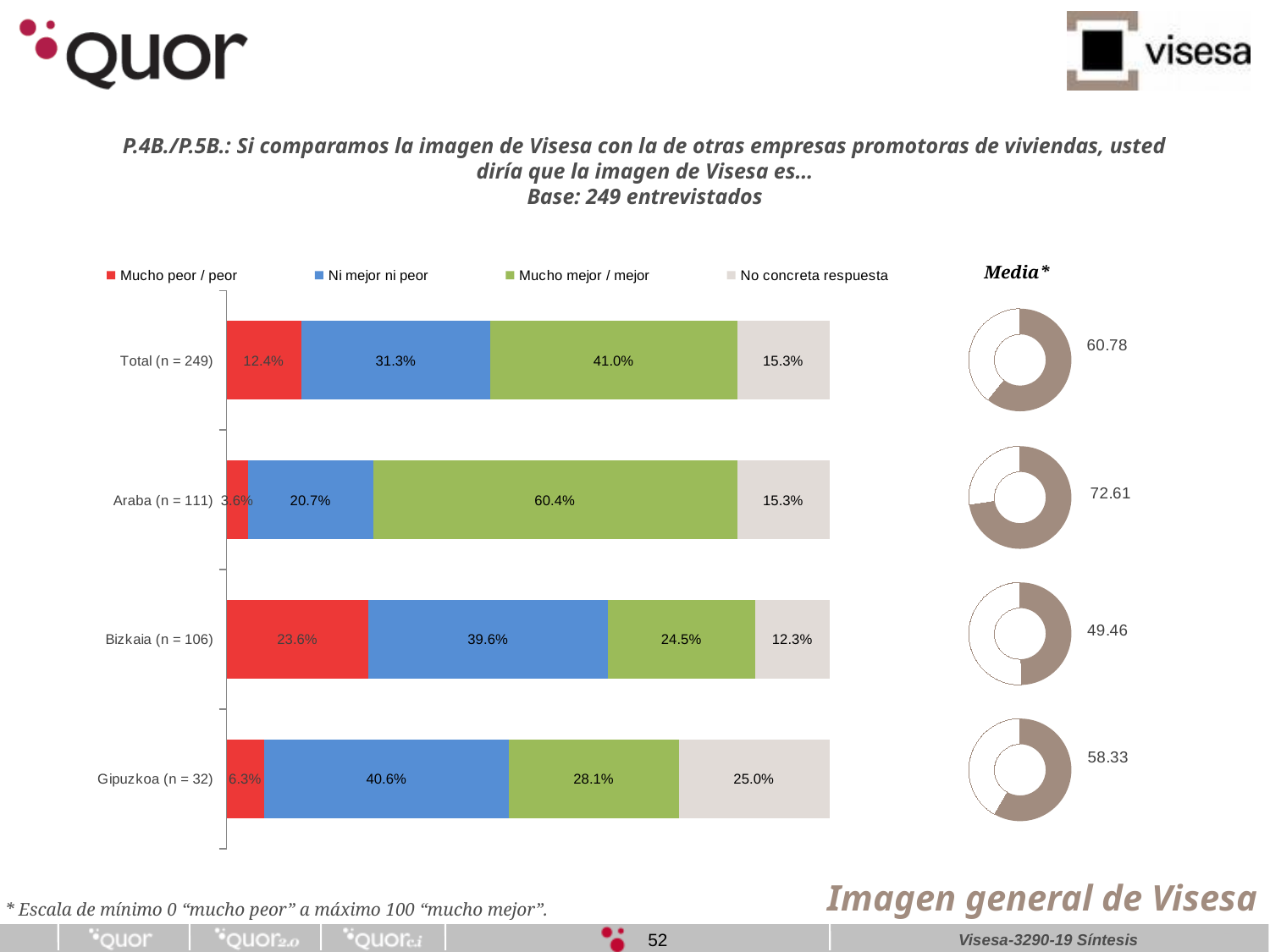
In the stacked bar chart, which category has the lowest "Mucho peor / peor" percentage? Araba (n = 111) In the stacked bar chart, what is the "No concreta respuesta" value for Gipuzkoa (n = 32)? 25.0% How many categories are shown in the stacked bar chart? 4 How many series does the legend of the stacked bar chart list? 4 In the stacked bar chart, what is the difference between the "Ni mejor ni peor" values for Gipuzkoa (n = 32) and Araba (n = 111)? 19.9% In the Media* donut charts, what is the mean value for Araba? 72.61 In the stacked bar chart, what percentage of Total (n = 249) respondents answered "Mucho mejor / mejor"? 41.0% Among the Media* donut charts, which territory has the lowest mean value? Bizkaia In the stacked bar chart, which category has the highest "Mucho mejor / mejor" percentage? Araba (n = 111) In the stacked bar chart, what is the "Mucho peor / peor" value for Bizkaia (n = 106)? 23.6% What type of chart is used to show the response breakdown by territory? Stacked bar chart In the stacked bar chart, is the "Mucho mejor / mejor" value larger for Bizkaia (n = 106) or for Gipuzkoa (n = 32)? Gipuzkoa (n = 32)